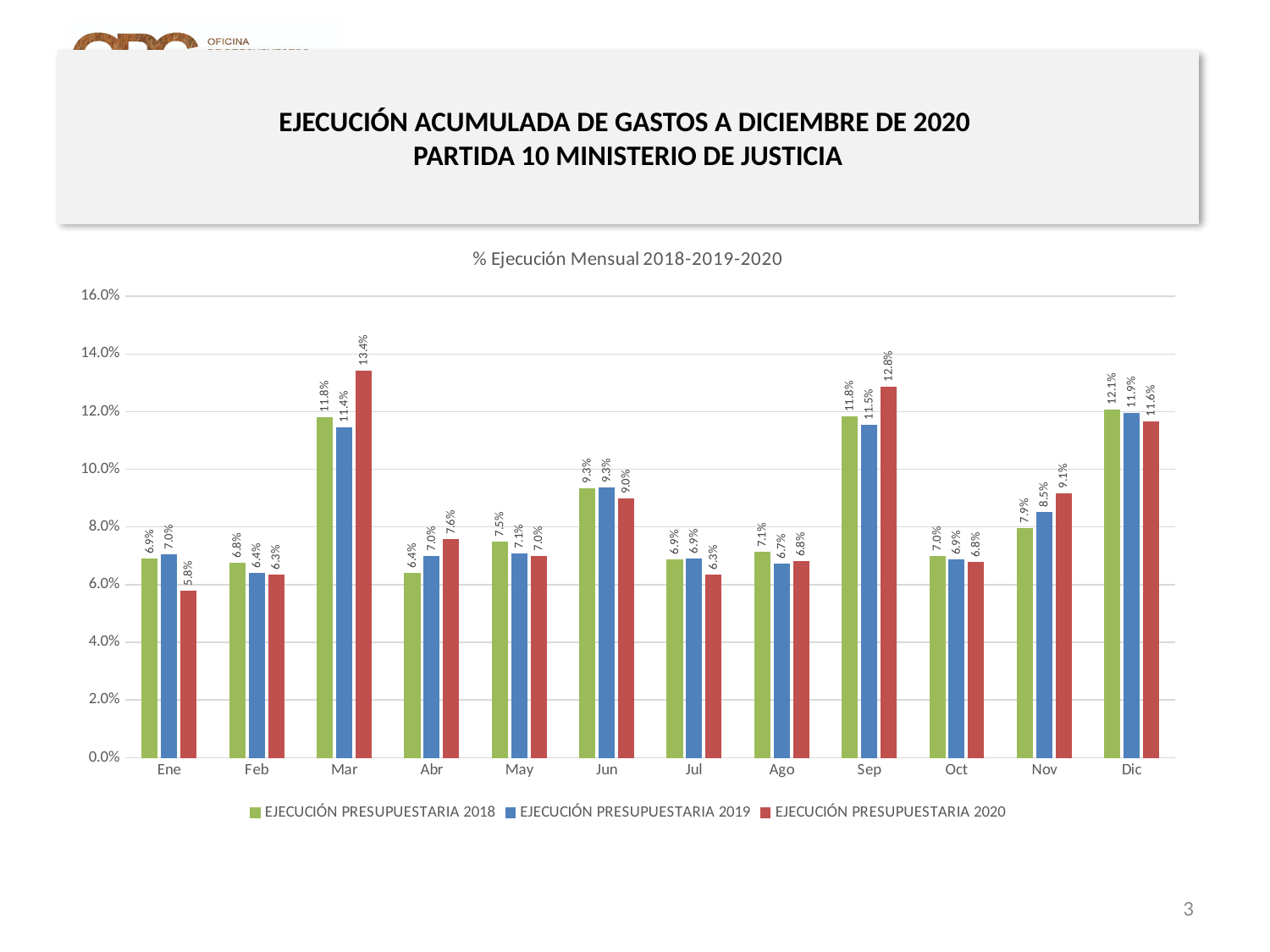
In which month is the EJECUCIÓN PRESUPUESTARIA 2020 value lowest? Ene How many series does the legend list? 3 What kind of chart is shown on the slide? Bar chart What is the difference between the 2020 and 2018 values in Mar? 1.6 percentage points Is the value for EJECUCIÓN PRESUPUESTARIA 2019 in Jun greater or less than 8.0%? greater What is the value for EJECUCIÓN PRESUPUESTARIA 2020 in Mar? 13.4% In which month is the EJECUCIÓN PRESUPUESTARIA 2020 value highest? Mar What is the value for EJECUCIÓN PRESUPUESTARIA 2019 in Nov? 8.5% Which is larger in Sep: the EJECUCIÓN PRESUPUESTARIA 2018 value or the EJECUCIÓN PRESUPUESTARIA 2020 value? EJECUCIÓN PRESUPUESTARIA 2020 What is the title of the chart? % Ejecución Mensual 2018-2019-2020 How many months are shown on the x axis? 12 What is the value for EJECUCIÓN PRESUPUESTARIA 2018 in Dic? 12.1%